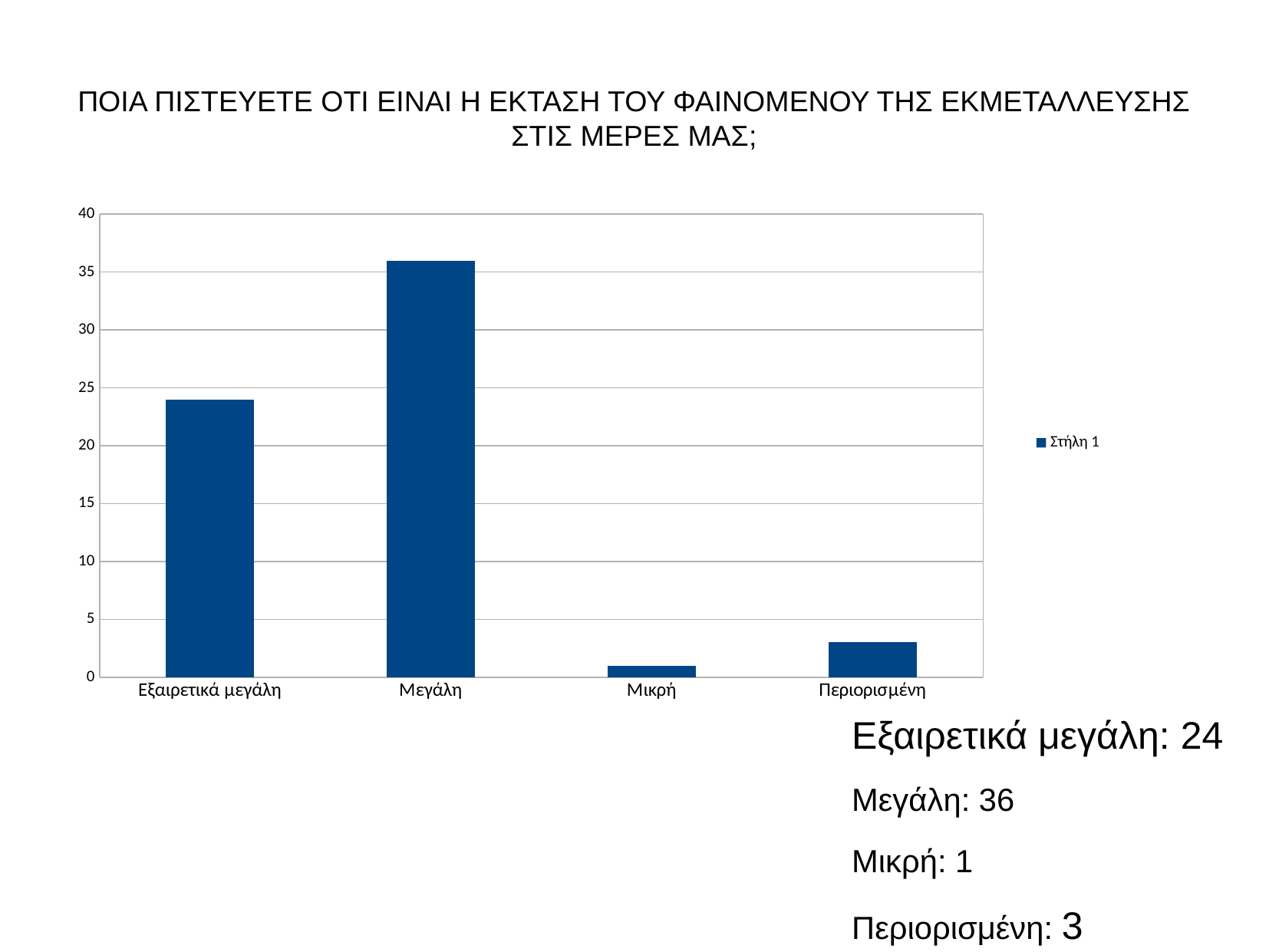
What kind of chart is shown on the slide? bar chart Which category has the highest value? Μεγάλη What is the value for Εξαιρετικά μεγάλη? 24 Is the value for Εξαιρετικά μεγάλη greater or less than 20? greater Which category has the lowest value? Μικρή What is the value for Μεγάλη? 36 How many categories are shown on the x axis? 4 What is the value for Περιορισμένη? 3 Which is larger, the value for Περιορισμένη or the value for Μικρή? Περιορισμένη What is the difference between the values for Μεγάλη and Εξαιρετικά μεγάλη? 12 What is the name of the series listed in the legend? Στήλη 1 What is the value for Μικρή? 1